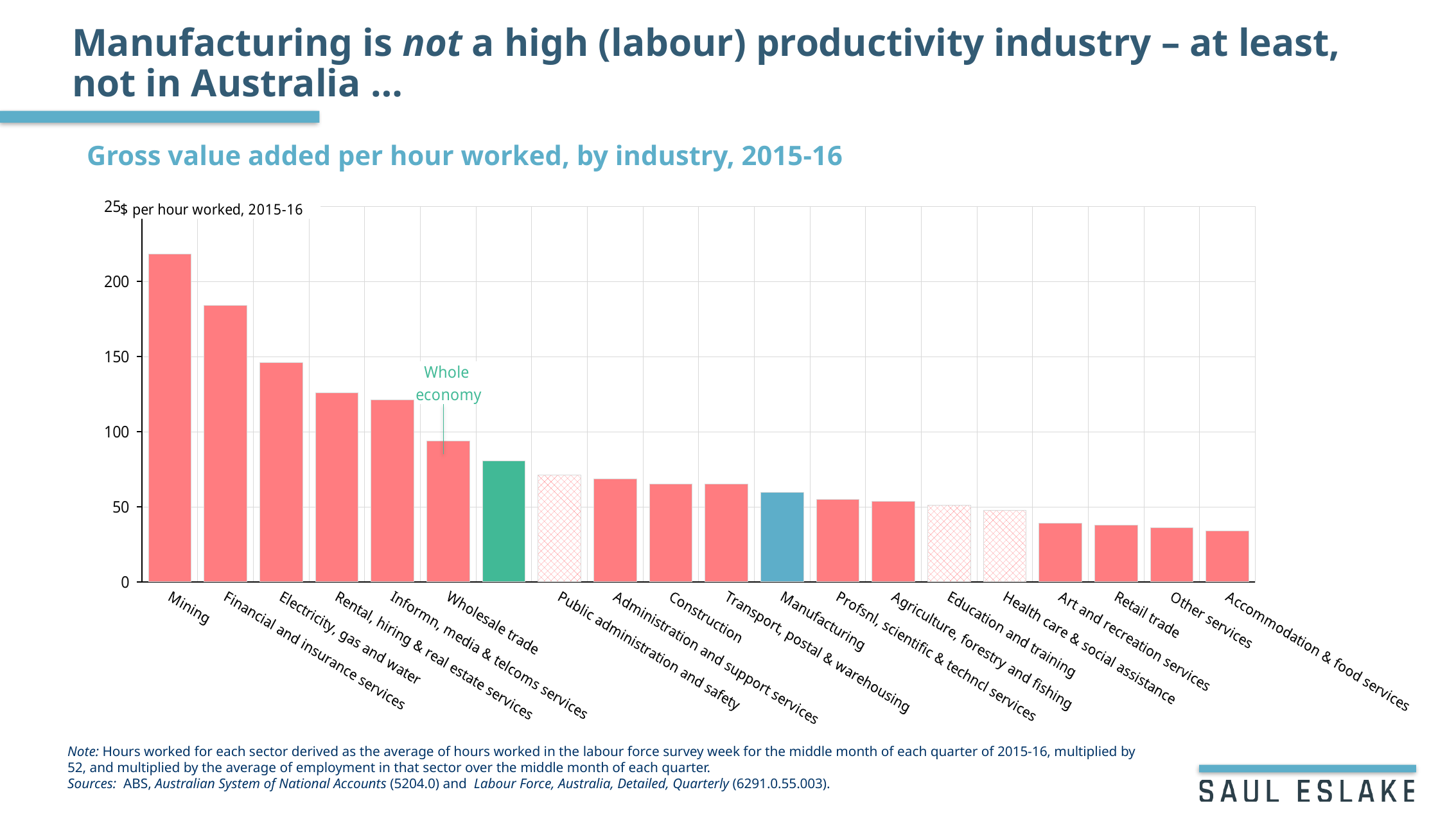
Do the values generally rise or fall moving from left to right along the x axis? fall Which is larger, the value for Manufacturing or the value for Wholesale trade? Wholesale trade Is the value for Electricity, gas and water greater or less than 100? greater Is the value for Financial and insurance services greater or less than 200? less Is the value for Manufacturing greater or less than 100? less Which industry has the highest gross value added per hour worked? Mining What is the title of the chart? Gross value added per hour worked, by industry, 2015-16 What kind of chart is shown on the slide? bar chart Which is larger, the value for Manufacturing or the value for Retail trade? Manufacturing